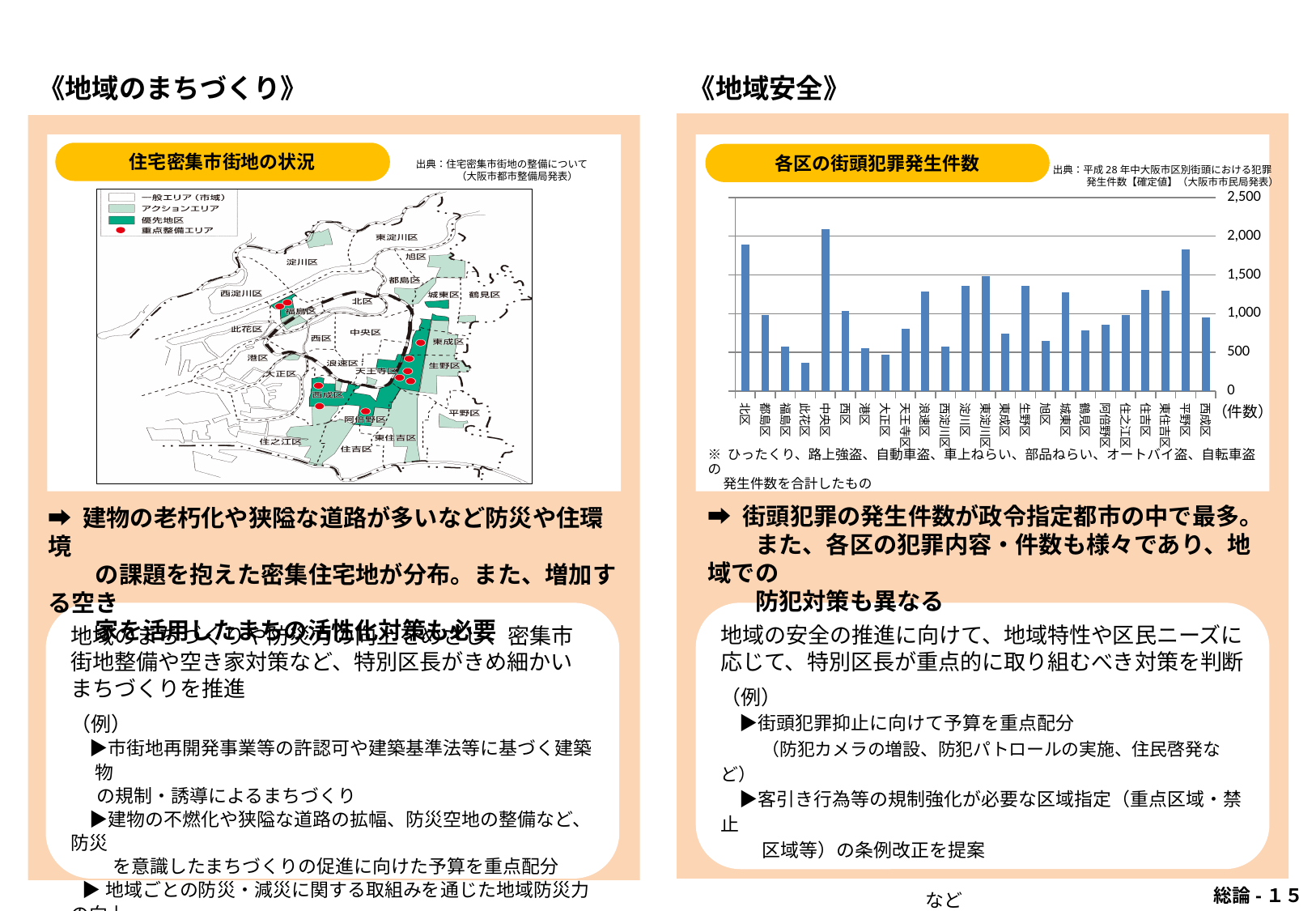
How many wards are shown on the x axis of the 各区の街頭犯罪発生件数 chart? 24 In the 各区の街頭犯罪発生件数 chart, is the value for 北区 greater or less than 1,500? greater What unit label is shown next to the vertical axis of the 各区の街頭犯罪発生件数 chart? 件数 In the 各区の街頭犯罪発生件数 chart, which ward has the lowest number of street crimes? 此花区 What is the maximum value shown on the vertical axis of the 各区の街頭犯罪発生件数 chart? 2,500 In the 各区の街頭犯罪発生件数 chart, which ward has more street crimes, 平野区 or 西成区? 平野区 What kind of chart is used to show 各区の街頭犯罪発生件数? bar chart In the 各区の街頭犯罪発生件数 chart, which ward has more street crimes, 中央区 or 北区? 中央区 In the 各区の街頭犯罪発生件数 chart, is the value for 中央区 greater or less than 2,000? greater In the 各区の街頭犯罪発生件数 chart, is the value for 天王寺区 greater or less than 1,000? less In the 各区の街頭犯罪発生件数 chart, which ward has the highest number of street crimes? 中央区